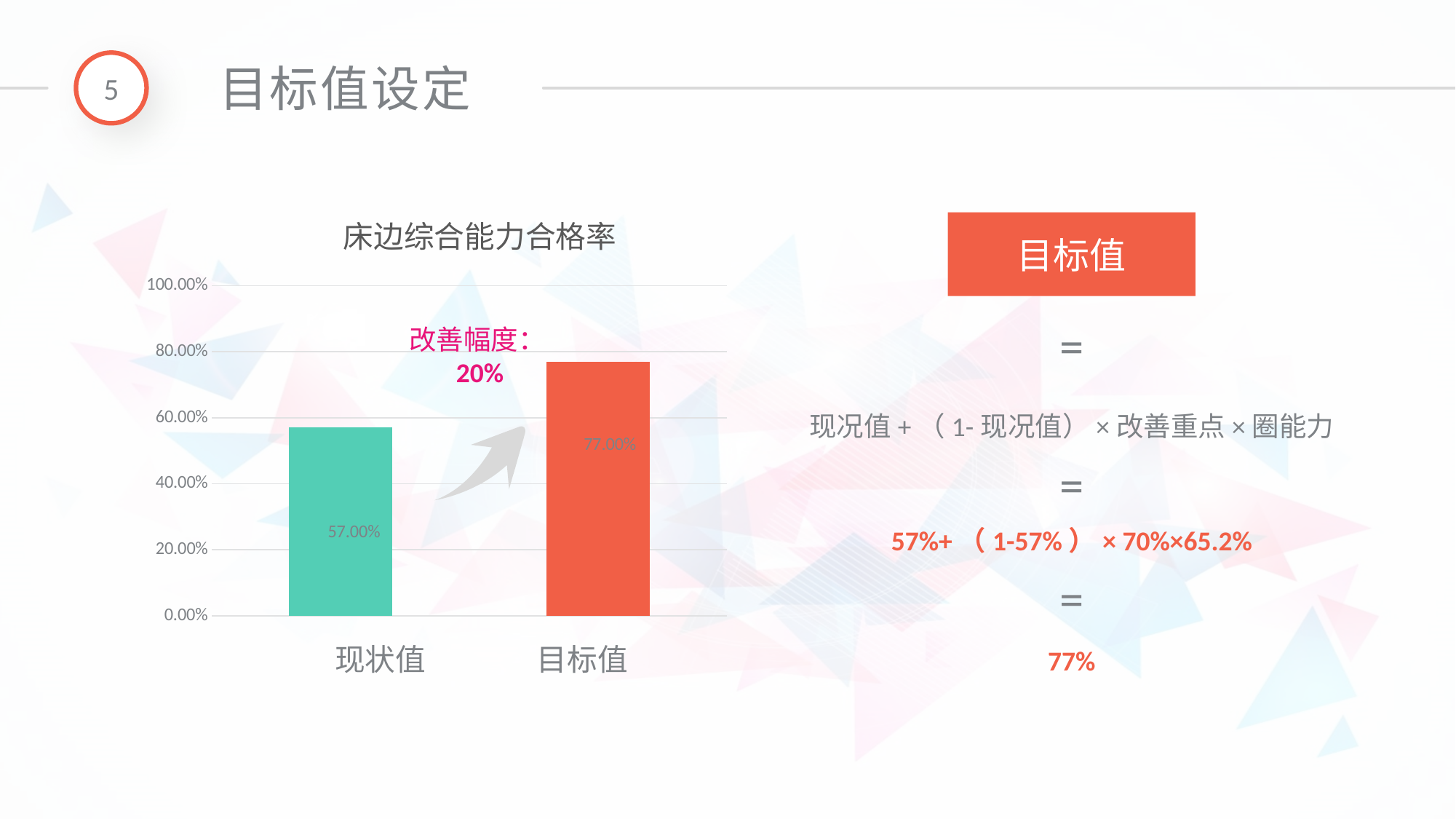
Which is larger, the value for 现状值 or the value for 目标值? 目标值 How many categories are shown in the chart? 2 What is the title of the chart? 床边综合能力合格率 Which category has the lowest value in the chart? 现状值 What improvement margin (改善幅度) is annotated on the chart? 20% What kind of chart is shown on the slide? bar chart What is the difference between the 目标值 and 现状值 values? 20.00% Is the value for 现状值 greater or less than 60.00%? less What is the value for 现状值 in the chart? 57.00% Is the value for 目标值 greater or less than 60.00%? greater Which category has the highest value in the chart? 目标值 What is the value for 目标值 in the chart? 77.00%